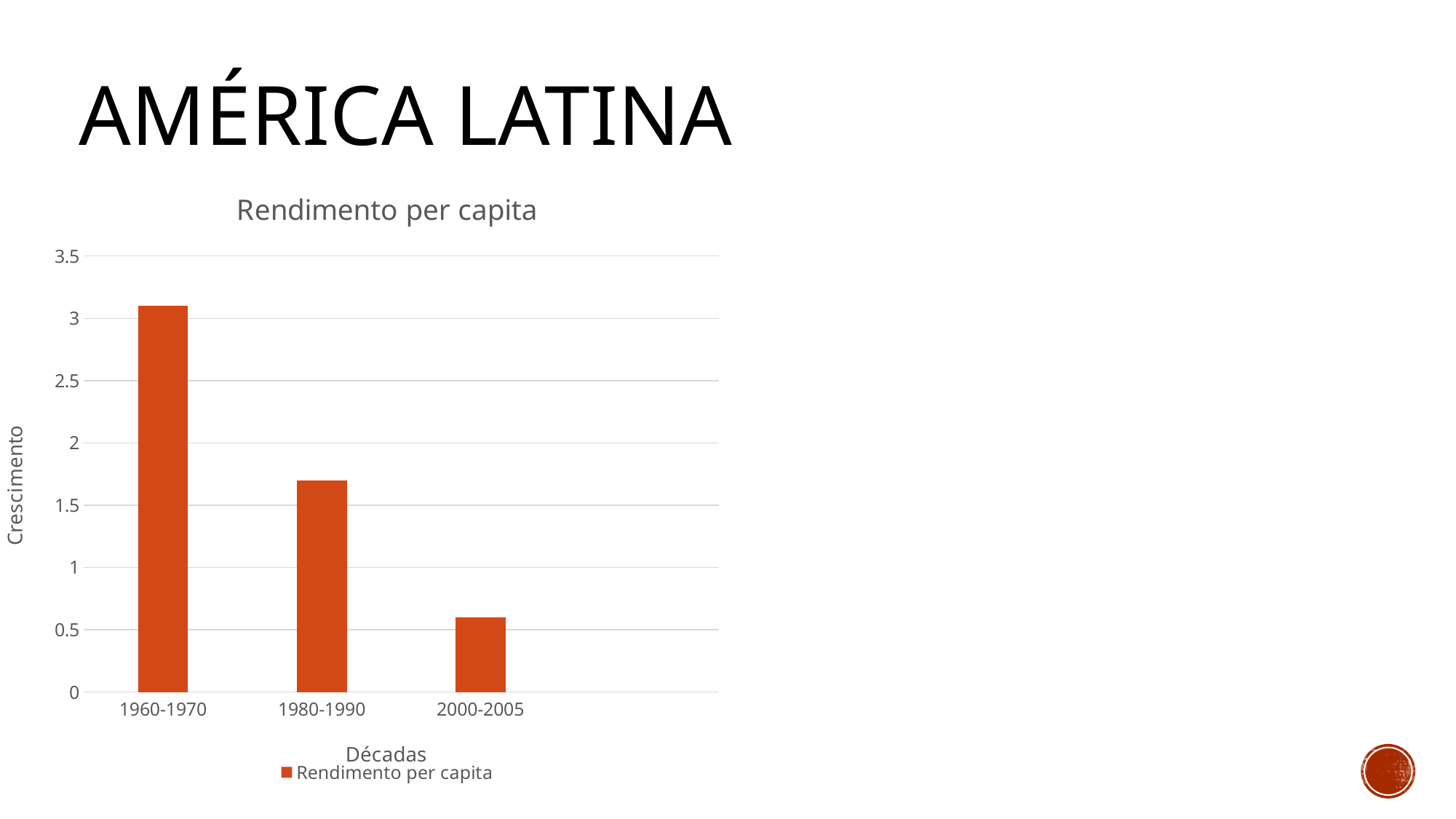
What type of chart is shown on the slide? bar chart Which década has the highest value? 1960-1970 Is the value for 2000-2005 greater or less than 1? less What is the title of the chart? Rendimento per capita How many categories (décadas) are shown on the x axis? 3 Is the value for 1980-1990 greater or less than 2? less How many series does the legend list? 1 Which is larger, the value for 1980-1990 or the value for 2000-2005? 1980-1990 Do the values rise or fall from 1960-1970 to 2000-2005? fall Is the value for 1980-1990 greater or less than 1.5? greater Which década has the lowest value? 2000-2005